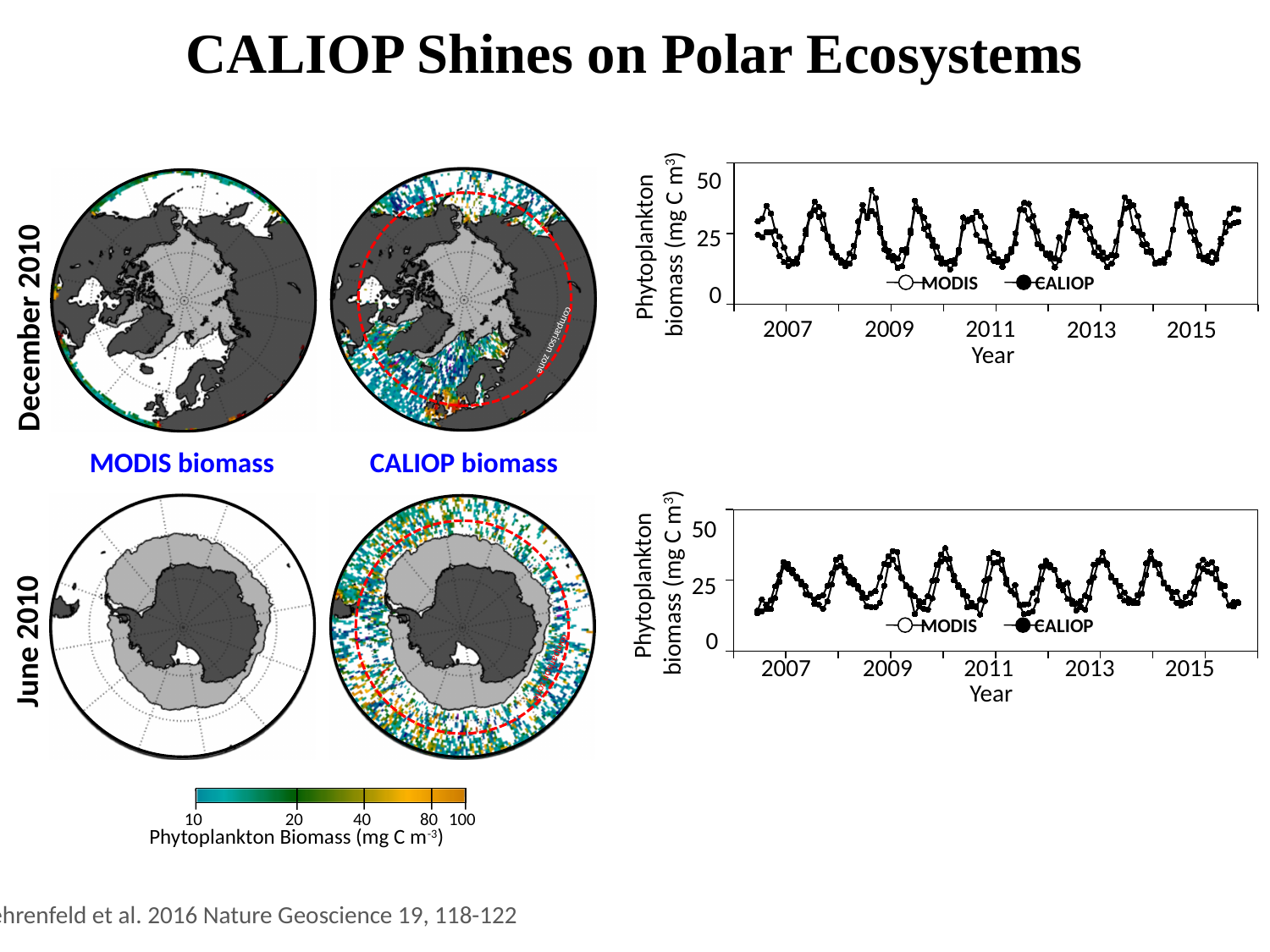
In the bottom line chart, is the peak value around 2009 greater or less than 25? greater In the bottom line chart, is the maximum value reached by either series greater or less than 50? less What is the first year label shown on the x axis of the top line chart? 2007 How many year labels are printed on the x axis of the bottom line chart? 5 Which series in the top line chart is drawn with filled (black) markers? CALIOP In the top line chart, are the lowest trough values greater or less than 25? less What are the two series named in the legend of the bottom line chart? MODIS and CALIOP What is the highest tick value printed on the y axis of the top line chart? 50 How many series does the legend of the top line chart list? 2 What is the x-axis label of the top line chart? Year What kind of chart is the top chart on the right of the slide? line chart